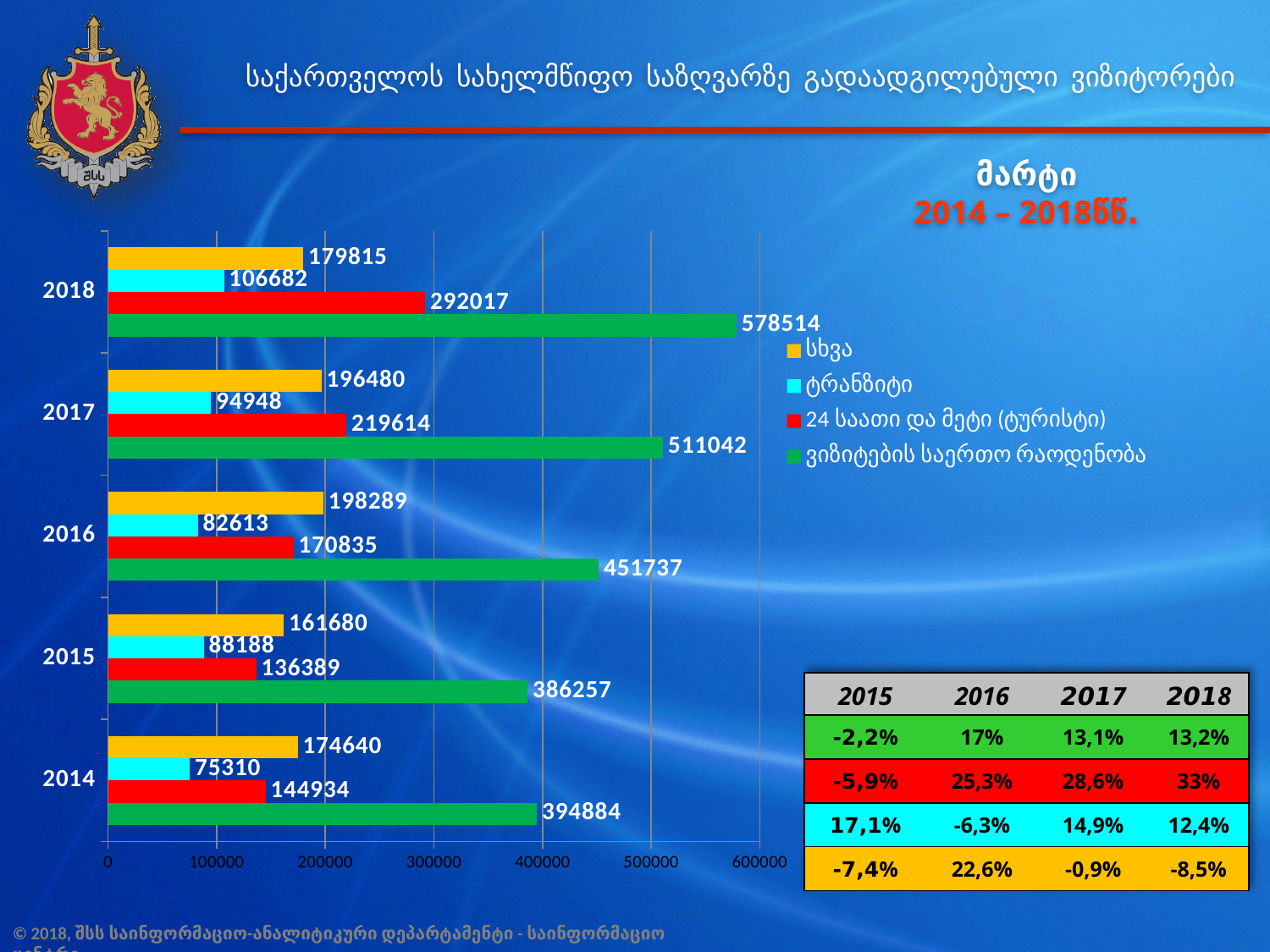
Is the green series value for 2016 greater or less than 400000? greater What is the value of the yellow series (სხვა) for 2015? 161680 What is the value of the green series (ვიზიტების საერთო რაოდენობა) for 2018? 578514 What kind of chart is shown on the slide? bar chart What is the value of the cyan series (ტრანზიტი) for 2014? 75310 How many series does the legend list? 4 In which year is the cyan series (ტრანზიტი) lowest? 2014 How many years are shown on the chart? 5 Which is larger: the red series value for 2015 or for 2014? 2014 What is the difference between the green series values for 2018 and 2017? 67472 What is the value of the red series (24 საათი და მეტი (ტურისტი)) for 2016? 170835 In which year is the green series (ვიზიტების საერთო რაოდენობა) highest? 2018